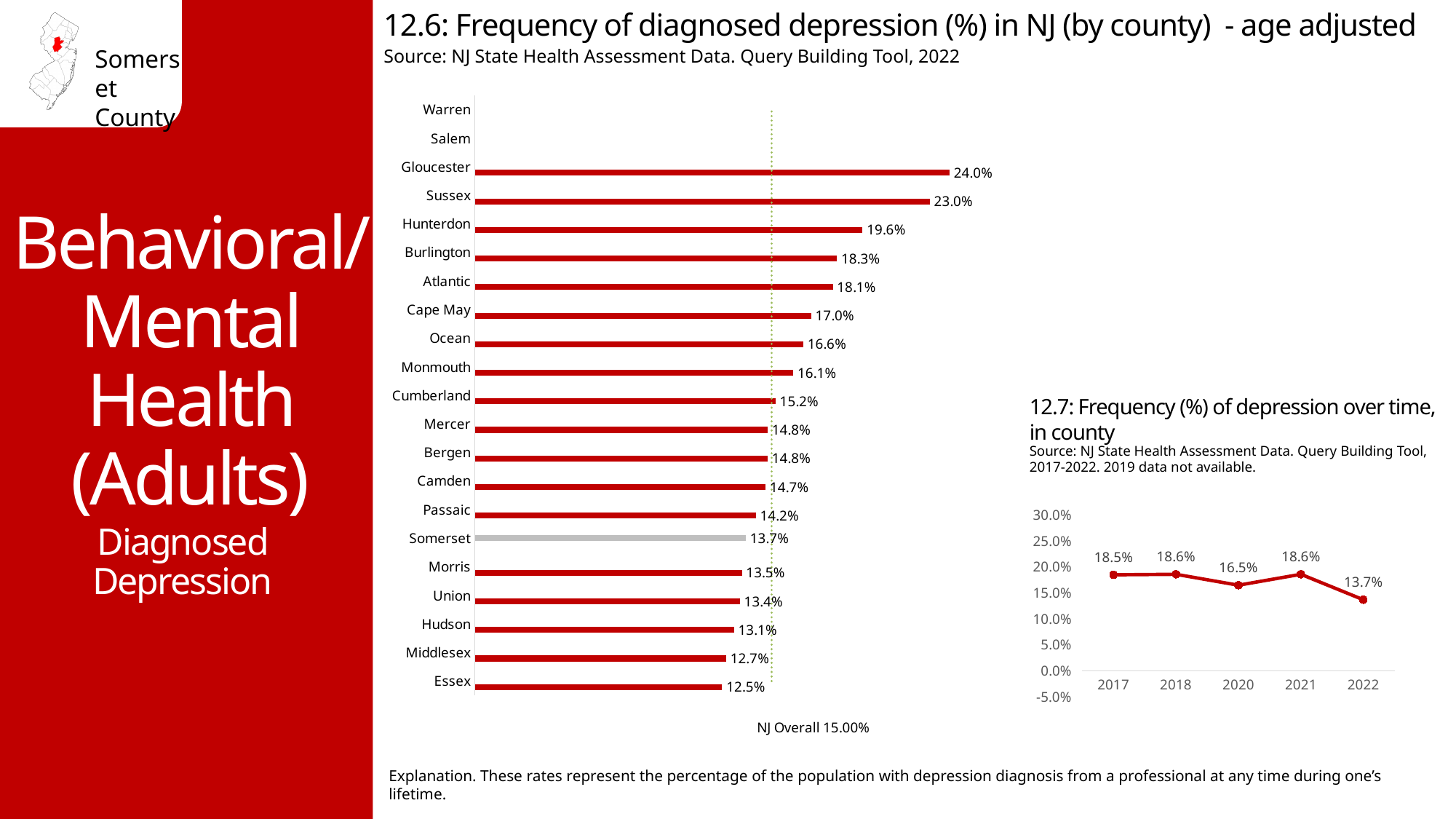
In chart 12.6, which county has the highest frequency of diagnosed depression? Gloucester In chart 12.7, what is the difference between the 2021 and 2022 values? 4.9% In chart 12.6, what NJ overall value is shown by the dotted reference line? 15.00% In chart 12.6, what is the frequency of diagnosed depression for Gloucester? 24.0% In chart 12.6, which county with a plotted bar has the lowest frequency of diagnosed depression? Essex In chart 12.6, what is the value shown for Somerset? 13.7% What type of chart is chart 12.6? Bar chart In chart 12.6, what is the difference between the values for Sussex and Hunterdon? 3.4% In chart 12.7, what is the frequency of depression in 2020? 16.5% In chart 12.7, which year has the lowest frequency of depression? 2022 In chart 12.6, which county has a higher value, Cape May or Ocean? Cape May In chart 12.7, how many years are plotted? 5